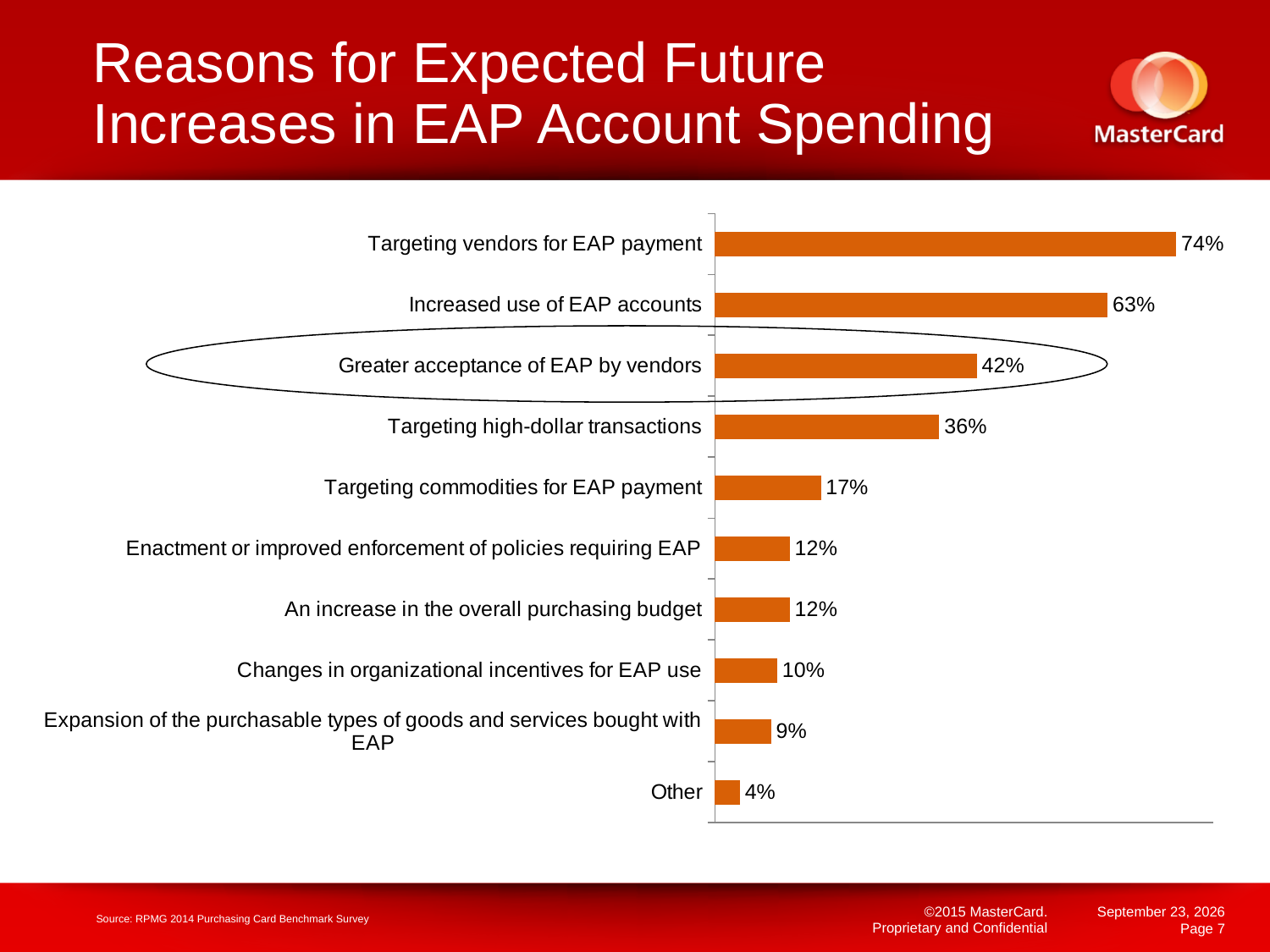
Which category has the highest value? Targeting vendors for EAP payment What kind of chart is shown on the slide? Bar chart What is the difference between "Targeting vendors for EAP payment" and "Increased use of EAP accounts"? 11% What is the difference between "Greater acceptance of EAP by vendors" and "Targeting high-dollar transactions"? 6% Which category is circled on the chart? Greater acceptance of EAP by vendors What is the value for "Targeting commodities for EAP payment"? 17% Which is larger: "Changes in organizational incentives for EAP use" or "Expansion of the purchasable types of goods and services bought with EAP"? Changes in organizational incentives for EAP use Which category has the lowest value? Other What is the value for "Targeting vendors for EAP payment"? 74% How many categories are shown in the chart? 10 What is the value for "Other"? 4% What is the value for "Greater acceptance of EAP by vendors"? 42%